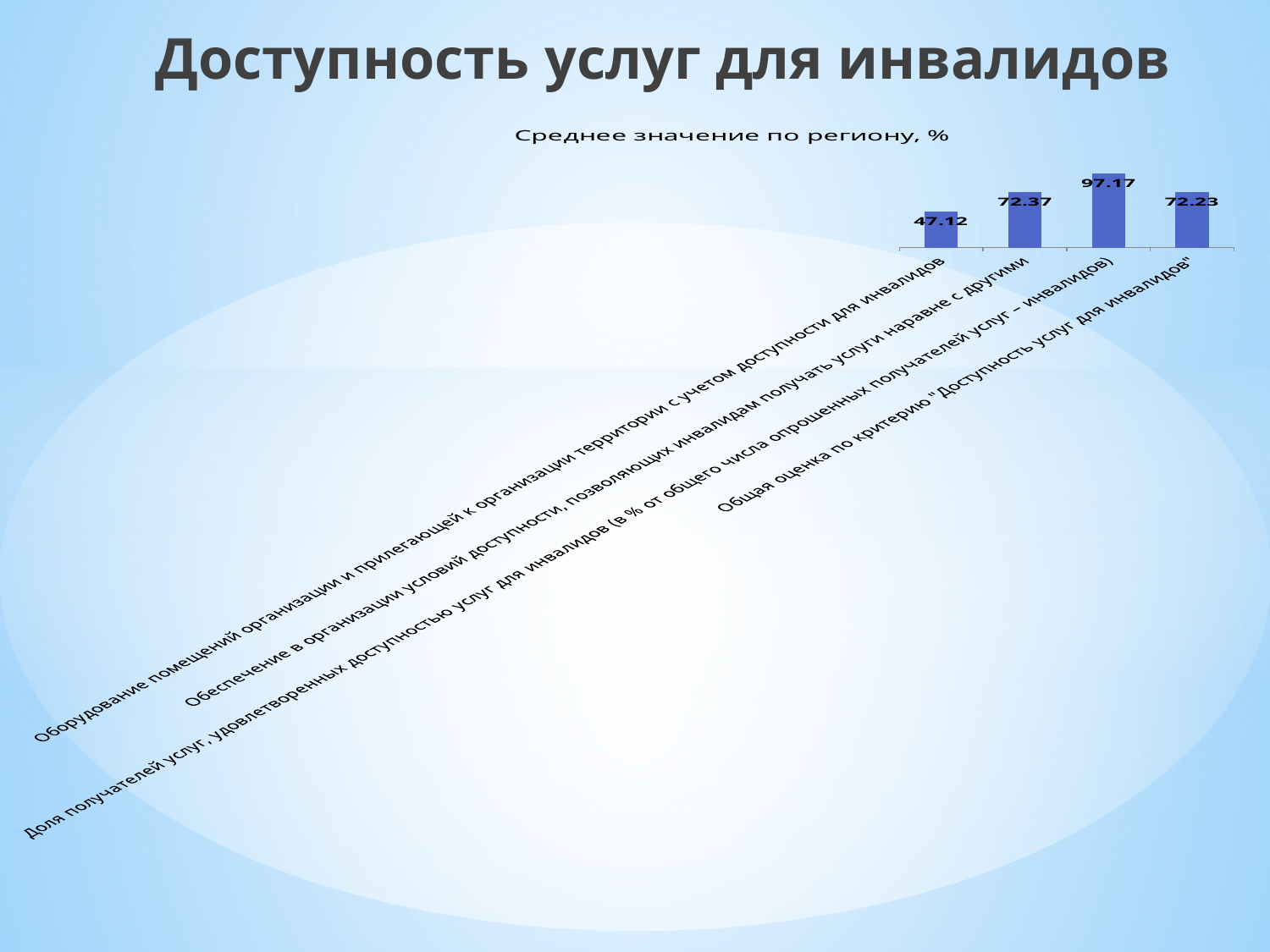
Which category has the lowest value? Оборудование помещений организации и прилегающей к организации территории с учетом доступности для инвалидов Which is larger: the value for "Обеспечение в организации условий доступности..." or the value for "Общая оценка по критерию "Доступность услуг для инвалидов""? Обеспечение в организации условий доступности, позволяющих инвалидам получать услуги наравне с другими What is the value for "Доля получателей услуг, удовлетворенных доступностью услуг для инвалидов"? 97.17 What colour are the bars in the chart? blue What is the value for "Общая оценка по критерию "Доступность услуг для инвалидов""? 72.23 What type of chart is shown on the slide? bar chart What is the value for "Оборудование помещений организации и прилегающей к организации территории с учетом доступности для инвалидов"? 47.12 What is the title of the chart? Среднее значение по региону, % What is the value for "Обеспечение в организации условий доступности, позволяющих инвалидам получать услуги наравне с другими"? 72.37 What is the difference between the highest value (97.17) and the lowest value (47.12)? 50.05 Which category has the highest value? Доля получателей услуг, удовлетворенных доступностью услуг для инвалидов How many bars (categories) does the chart show? 4